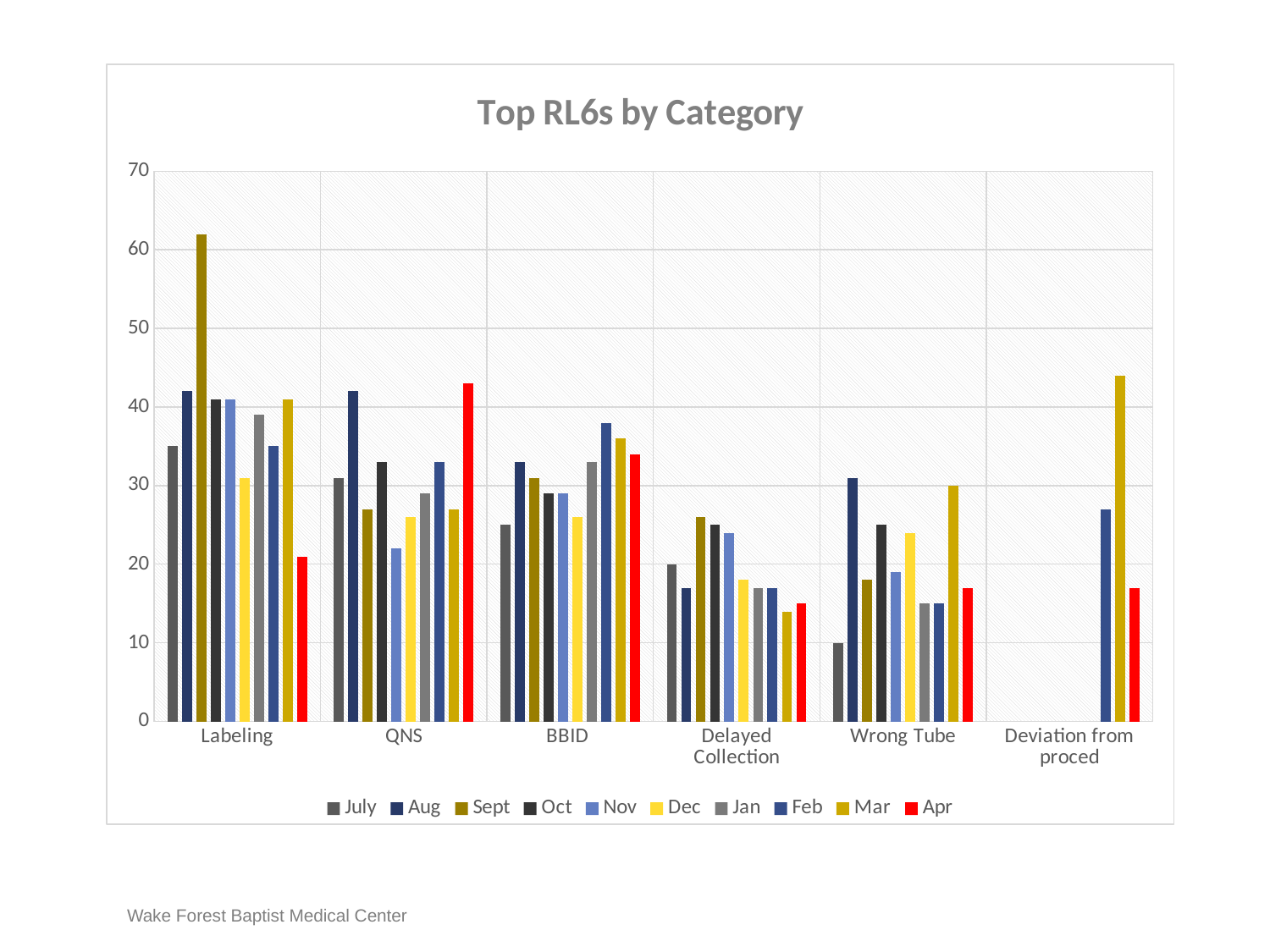
In the Wrong Tube category, which is larger, the value for Aug or the value for July? Aug Which month has the highest value in the QNS category? Apr What is the title of the chart? Top RL6s by Category Is the value for Mar in the Deviation from proced category greater or less than 40? greater How many series does the legend list? 10 How many categories are shown on the x axis? 6 Is the value for Apr in the Delayed Collection category greater or less than 20? less Which month has the highest value in the Labeling category? Sept Which month has the lowest value in the Wrong Tube category? July Is the value for Sept in the Labeling category greater or less than 50? greater What type of chart is shown on the slide? bar chart Which month has the highest value in the Deviation from proced category? Mar